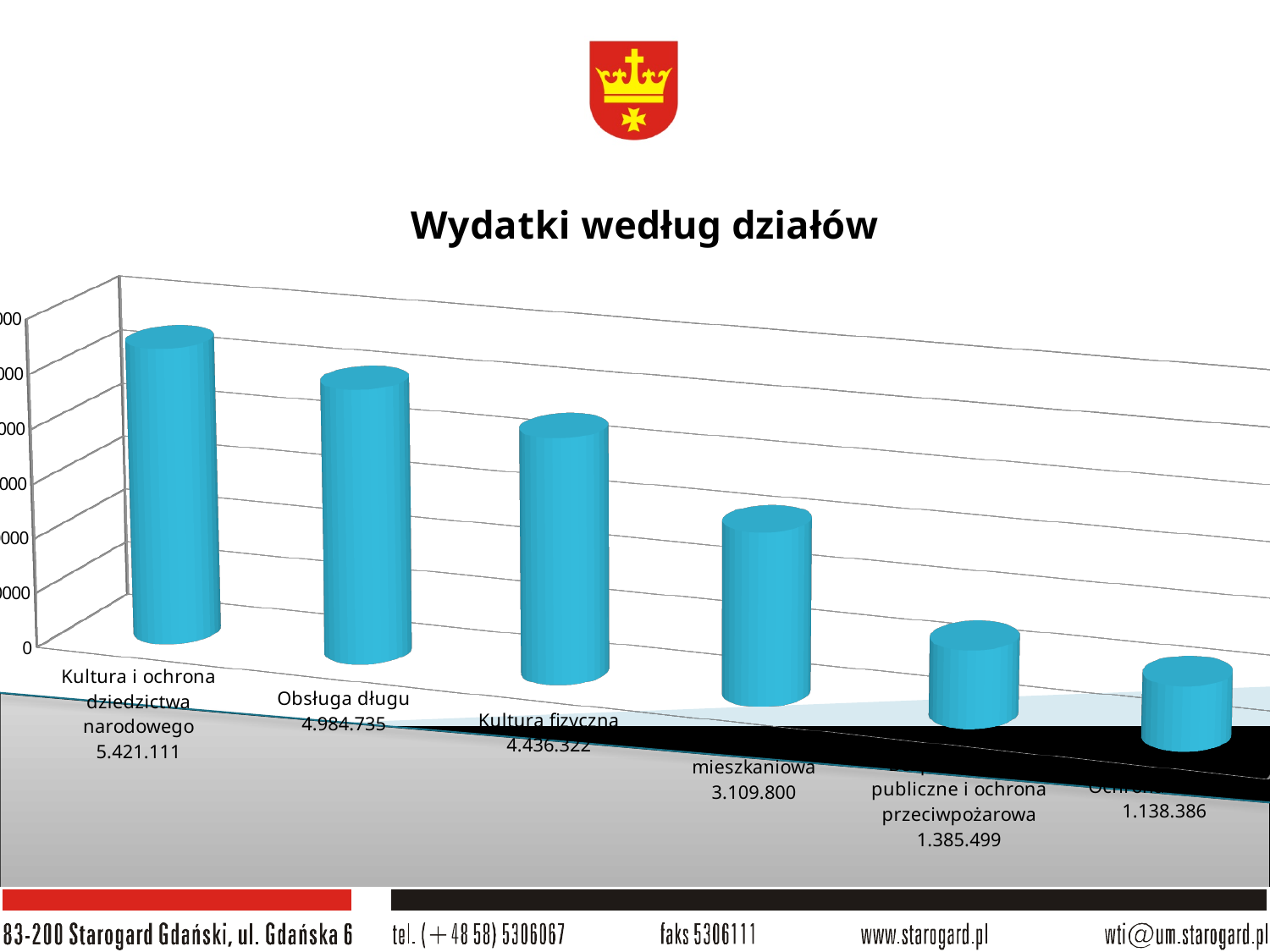
What is the value of the lowest bar in the chart? 1.138.386 How many bars does the chart show? 6 Which is larger, Obsługa długu or Kultura fizyczna? Obsługa długu What is the value for Obsługa długu? 4.984.735 What is the value of the rightmost bar in the chart? 1.138.386 What kind of chart is shown on the slide? bar chart What is the difference between Kultura i ochrona dziedzictwa narodowego and Obsługa długu? 436.376 Which category has the highest value? Kultura i ochrona dziedzictwa narodowego Do the values rise or fall from left to right across the chart? fall What is the value for Kultura fizyczna? 4.436.322 What is the value for Kultura i ochrona dziedzictwa narodowego? 5.421.111 What is the title of the chart? Wydatki według działów